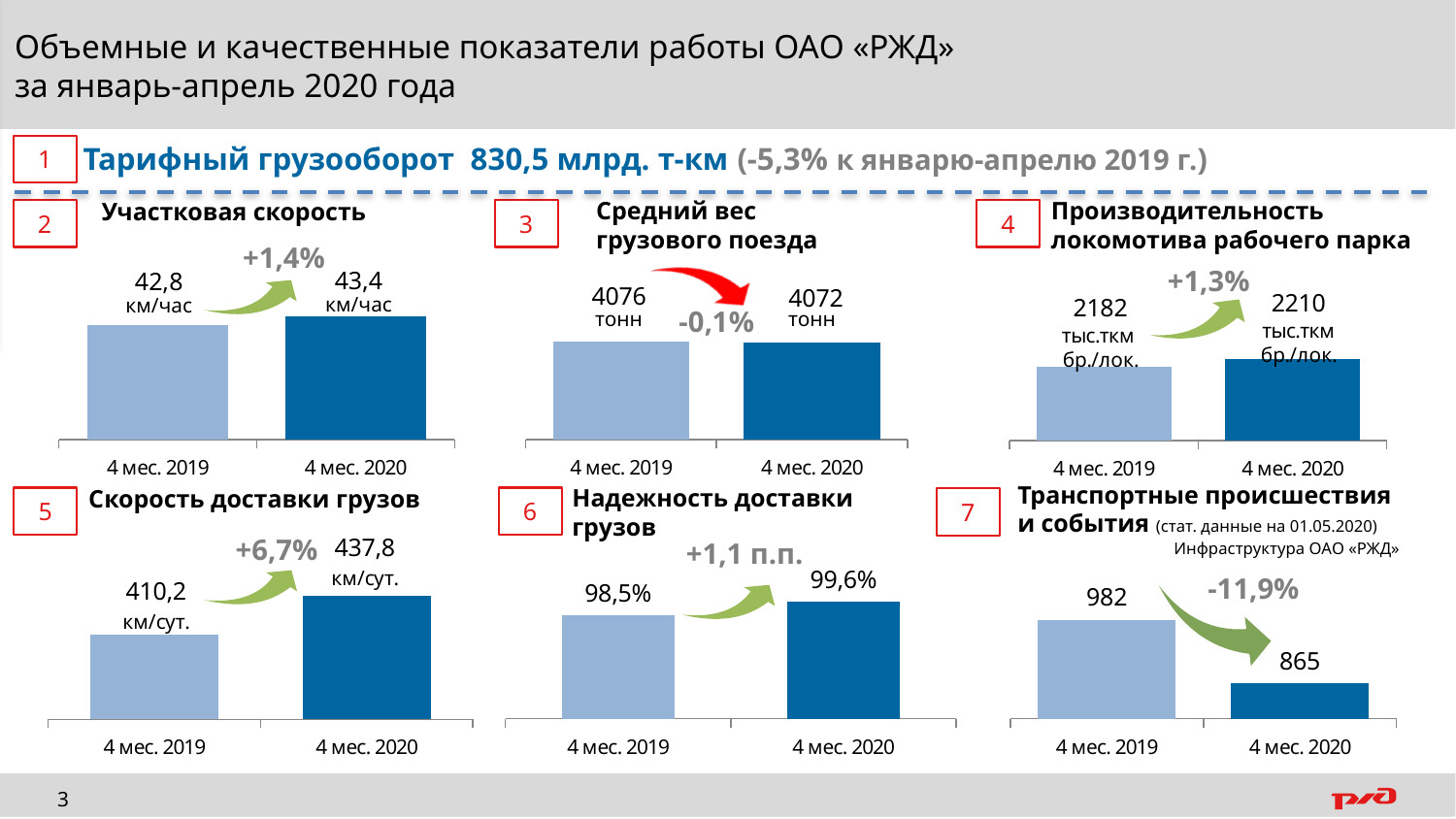
In the "Надежность доставки грузов" chart, what is the value for 4 мес. 2019? 98,5% In the "Производительность локомотива рабочего парка" chart, which period has the higher value? 4 мес. 2020 In the "Скорость доставки грузов" chart, what is the difference between the 4 мес. 2020 and 4 мес. 2019 values? 27,6 км/сут. What kind of chart is the "Надежность доставки грузов" chart? bar chart In the "Участковая скорость" chart, what is the value for 4 мес. 2019? 42,8 км/час In the "Средний вес грузового поезда" chart, what is the difference between the 4 мес. 2019 and 4 мес. 2020 values? 4 тонн In the "Транспортные происшествия и события" chart, which period has the lower value? 4 мес. 2020 In the "Скорость доставки грузов" chart, what is the value for 4 мес. 2020? 437,8 км/сут. In the "Производительность локомотива рабочего парка" chart, what is the value for 4 мес. 2019? 2182 тыс.ткм бр./лок. In the "Средний вес грузового поезда" chart, what is the value for 4 мес. 2020? 4072 тонн In the "Участковая скорость" chart, what is the value for 4 мес. 2020? 43,4 км/час In the "Транспортные происшествия и события" chart, what is the value for 4 мес. 2020? 865